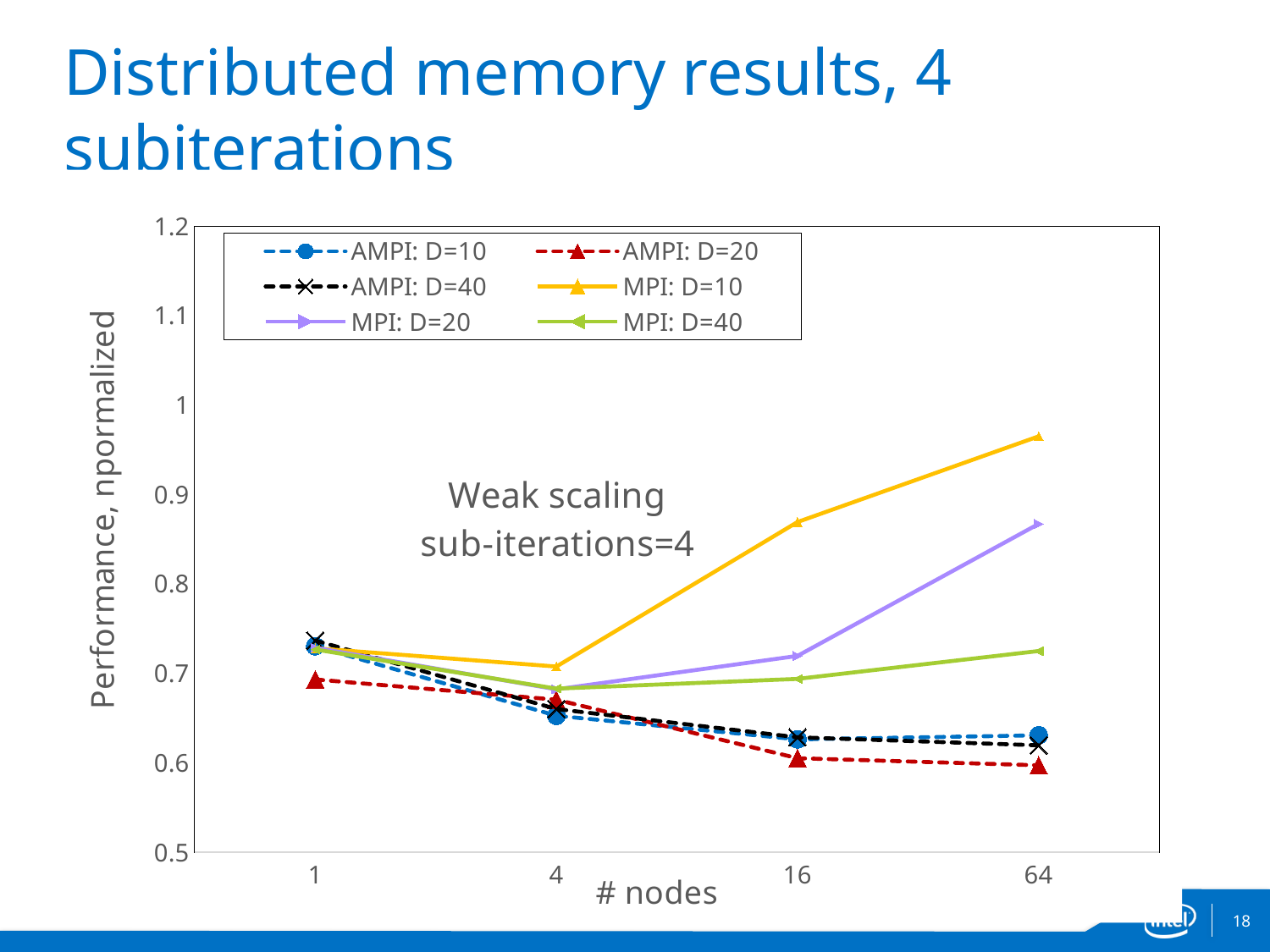
Is the value for MPI: D=10 at 64 nodes greater or less than 0.9? greater How many series does the legend list? 6 Is the value for AMPI: D=10 at 4 nodes greater or less than 0.7? less At 64 nodes, which is larger: MPI: D=20 or MPI: D=40? MPI: D=20 Which series has the highest performance at 64 nodes? MPI: D=10 Which series has the lowest performance at 64 nodes? AMPI: D=20 How many node counts are plotted along the x axis? 4 What is the label of the x axis? # nodes Is the value for MPI: D=20 at 64 nodes greater or less than 0.9? less Does the MPI: D=10 series rise or fall from 4 nodes to 64 nodes? rise What kind of chart is shown on the slide? line chart